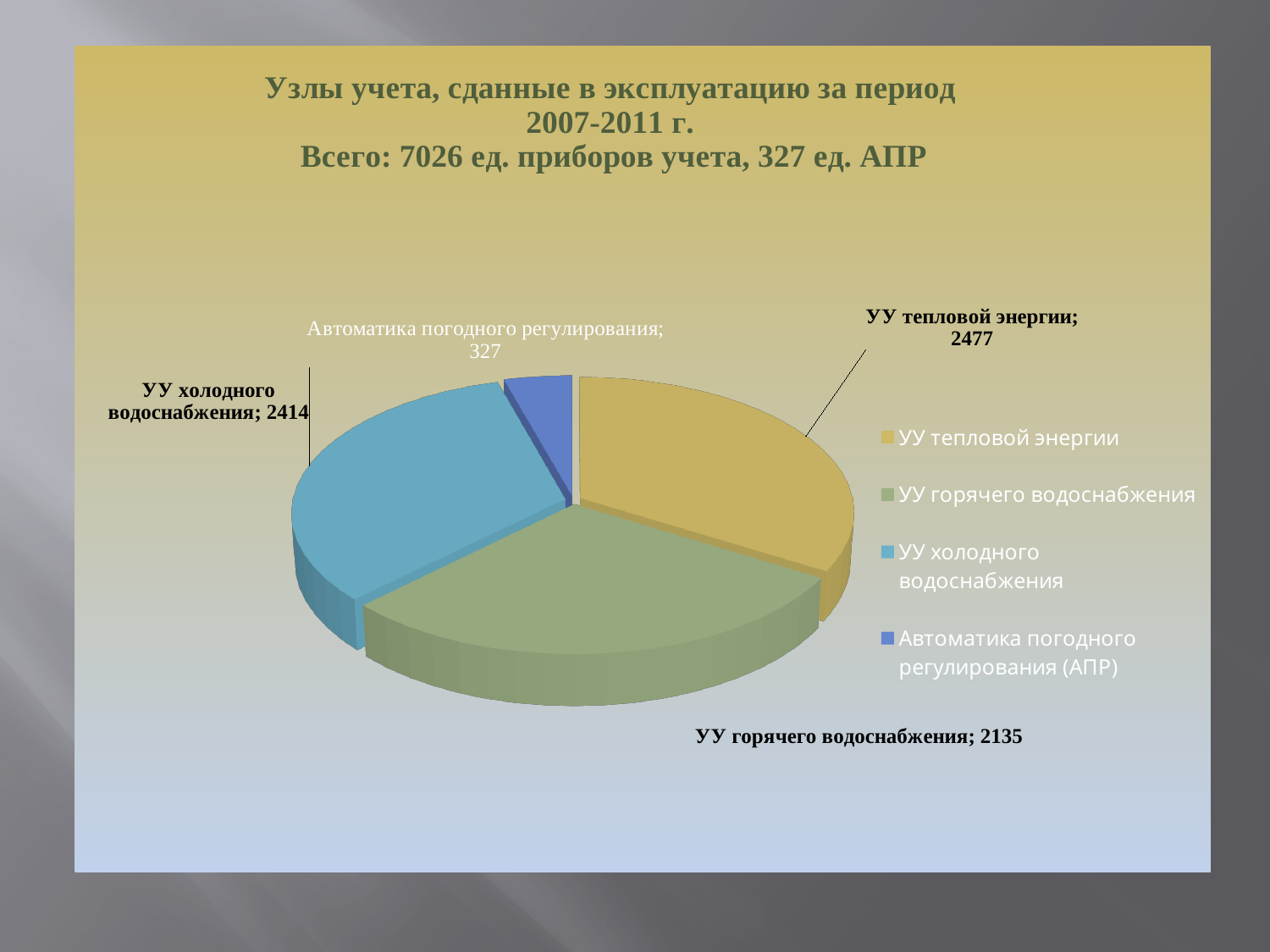
What is the value for Автоматика погодного регулирования? 327 What is the difference between УУ тепловой энергии and УУ горячего водоснабжения? 342 How many slices does the pie chart have? 4 What is the value for УУ горячего водоснабжения? 2135 Which category has the largest value? УУ тепловой энергии Which is larger: УУ холодного водоснабжения or УУ горячего водоснабжения? УУ холодного водоснабжения What type of chart is shown on the slide? pie chart What is the difference between УУ холодного водоснабжения and Автоматика погодного регулирования? 2087 Which category has the smallest value? Автоматика погодного регулирования What is the value for УУ холодного водоснабжения? 2414 What is the value for УУ тепловой энергии? 2477 What is the total of all slices in the pie chart? 7353